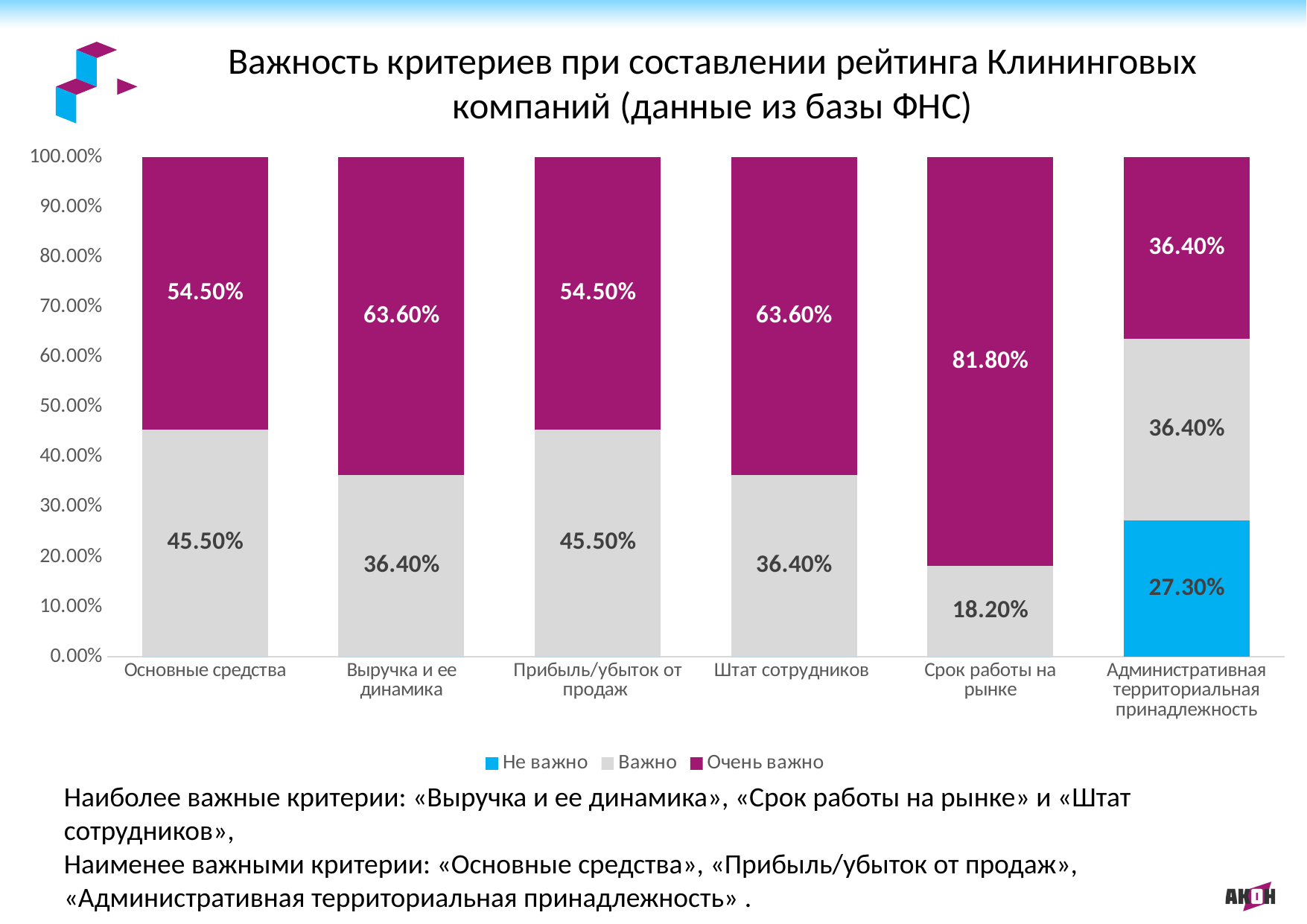
What is the difference between the 'Очень важно' values for 'Срок работы на рынке' and 'Штат сотрудников'? 18.20% What is the 'Не важно' value for 'Административная территориальная принадлежность'? 27.30% Which criterion is the only one with a 'Не важно' segment? Административная территориальная принадлежность Which is larger: the 'Очень важно' value for 'Основные средства' or for 'Штат сотрудников'? Штат сотрудников What colour represents the 'Очень важно' series? Magenta (purple) How many series does the legend list? 3 Which criterion has the highest 'Очень важно' share? Срок работы на рынке Which criterion has the lowest 'Важно' share? Срок работы на рынке How many criteria (categories) are shown on the x axis? 6 What is the 'Важно' value for 'Выручка и ее динамика'? 36.40% What is the 'Очень важно' value for 'Срок работы на рынке'? 81.80% What type of chart is shown on the slide? Stacked bar chart